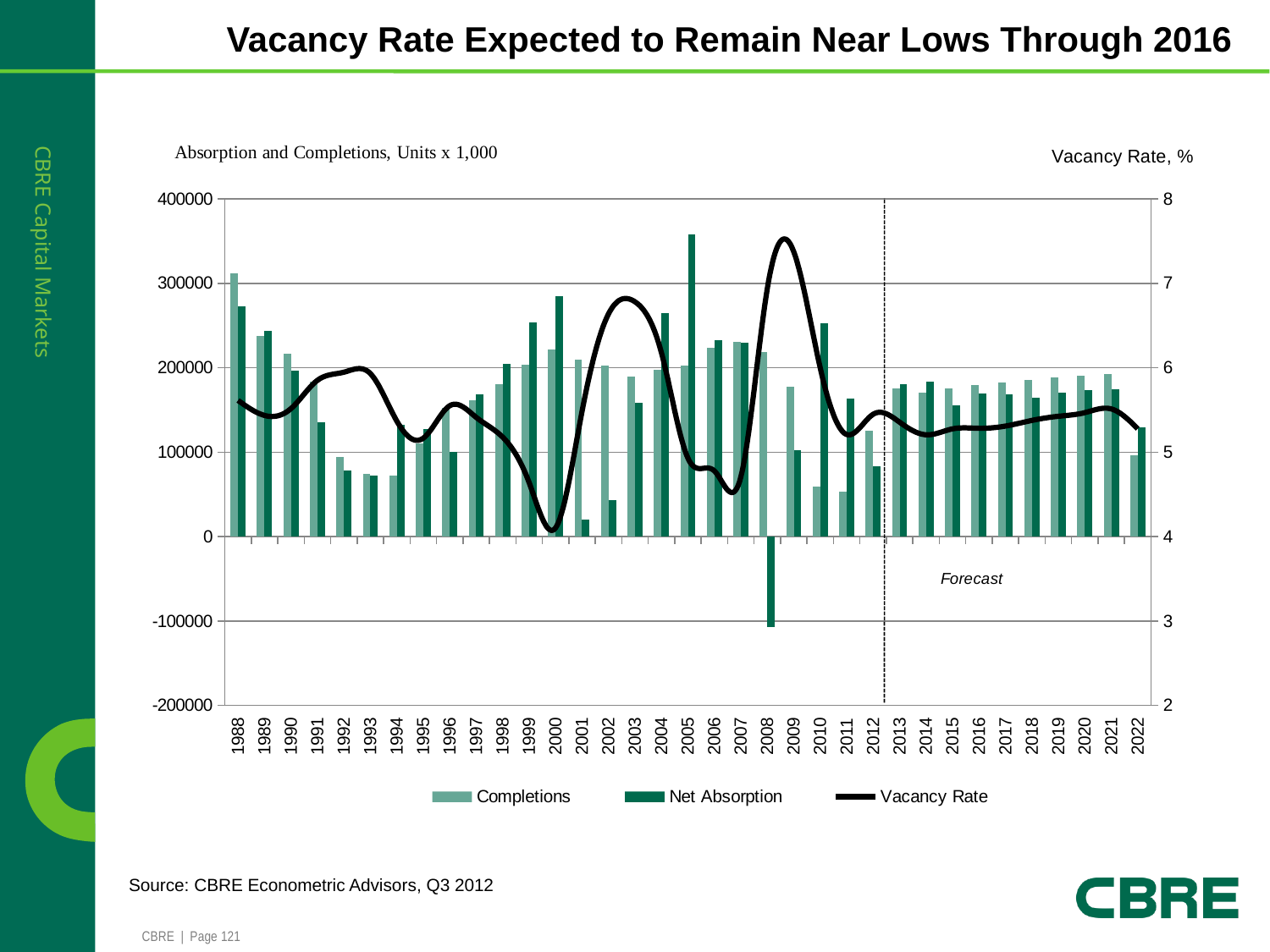
Does the Vacancy Rate rise or fall from 2009 to 2011? Fall Is the Net Absorption value for 2008 greater or less than 0? less What does the dashed vertical line on the chart mark the start of? Forecast Is the Net Absorption value for 2005 greater or less than 300000? greater Which year has the highest Completions? 1988 Which year has the highest Net Absorption? 2005 How many years are shown along the x axis? 35 How many series does the legend list? 3 Is the Vacancy Rate for 2000 greater or less than 5? less What kind of chart is shown on the slide? A bar chart combined with a line chart In 1988, which is larger: Completions or Net Absorption? Completions Which year has the lowest Net Absorption? 2008